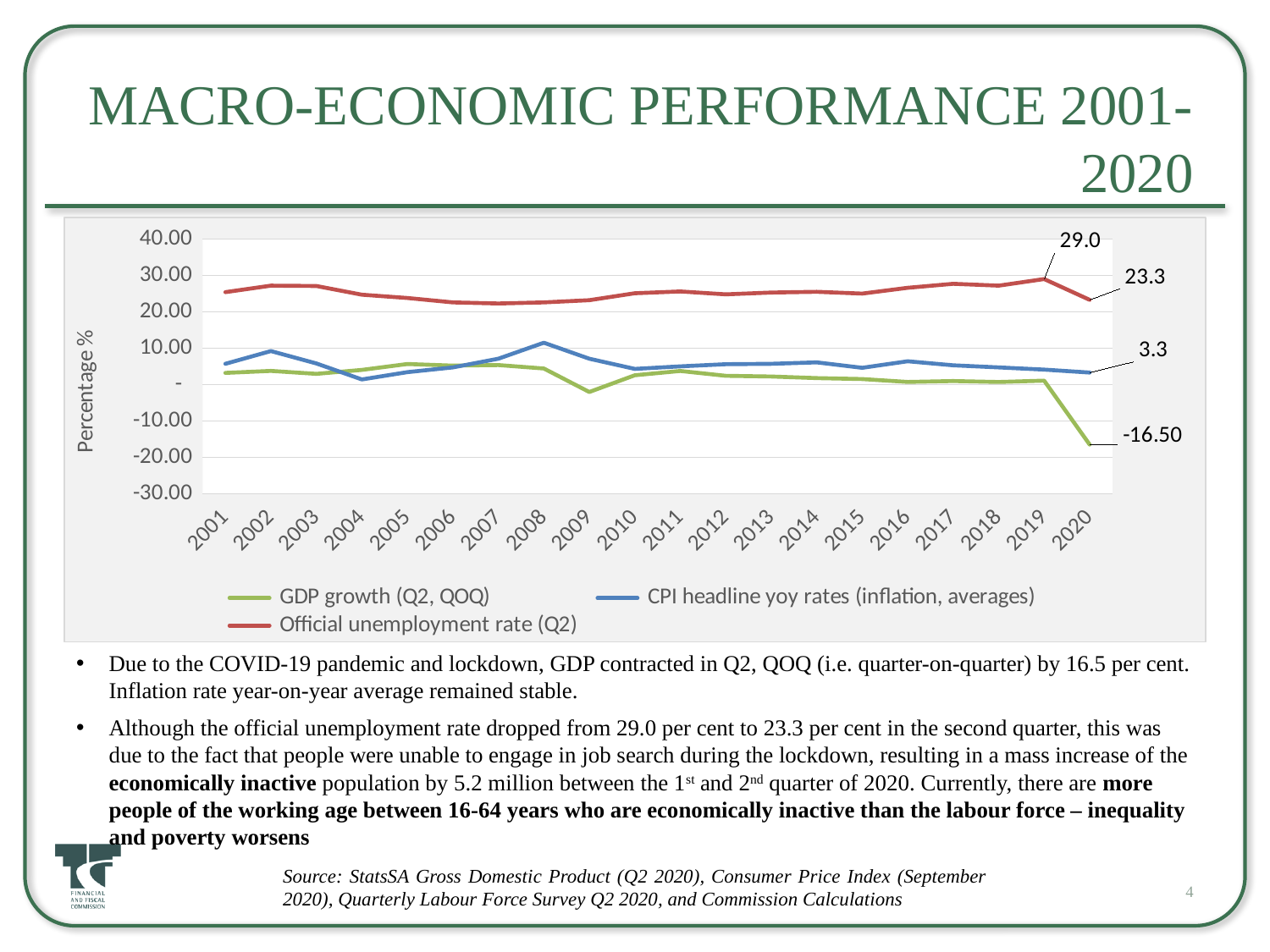
What is the GDP growth (Q2, QOQ) value for 2020? -16.50 What type of chart is shown on the slide? line chart Which series has the lowest value in 2020? GDP growth (Q2, QOQ) What is the CPI headline yoy rate for 2020? 3.3 How many series does the chart legend list? 3 What is the official unemployment rate (Q2) for 2019? 29.0 By how much did the official unemployment rate (Q2) fall from 2019 to 2020? 5.7 How many years are plotted along the x axis of the chart? 20 What is the official unemployment rate (Q2) for 2020? 23.3 What is the label on the y axis of the chart? Percentage % In 2020, which is larger: the official unemployment rate (Q2) or the CPI headline yoy rate? Official unemployment rate (Q2) Is the official unemployment rate (Q2) for 2001 greater or less than 20? greater